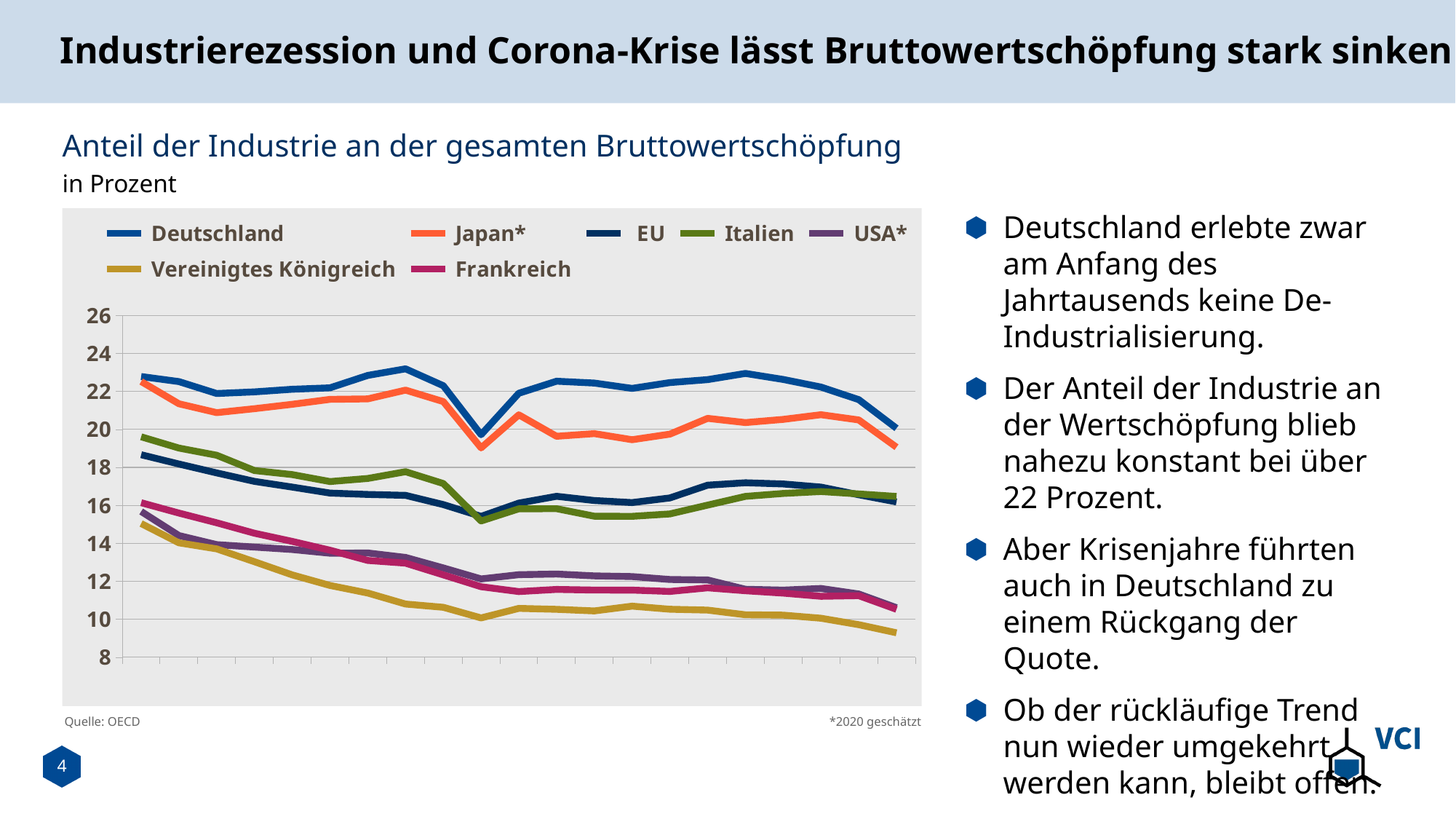
Which series has the highest values across the chart? Deutschland How many series does the legend of the chart list? 7 At the left end of the chart, which is higher: Italien or EU? Italien What kind of chart is shown on the slide? line chart Is the value for Vereinigtes Königreich at the right end of the chart greater or less than 10? less Do the values for Vereinigtes Königreich generally rise or fall along the x axis? fall What is the title of the chart? Anteil der Industrie an der gesamten Bruttowertschöpfung At the left end of the chart, which is higher: Deutschland or Japan*? Deutschland Is the value for Deutschland at the left end of the chart greater or less than 22? greater Which series has the lowest value at the right end of the chart? Vereinigtes Königreich Which series is drawn in orange in the chart? Japan* Is the value for Italien at the left end of the chart greater or less than 18? greater